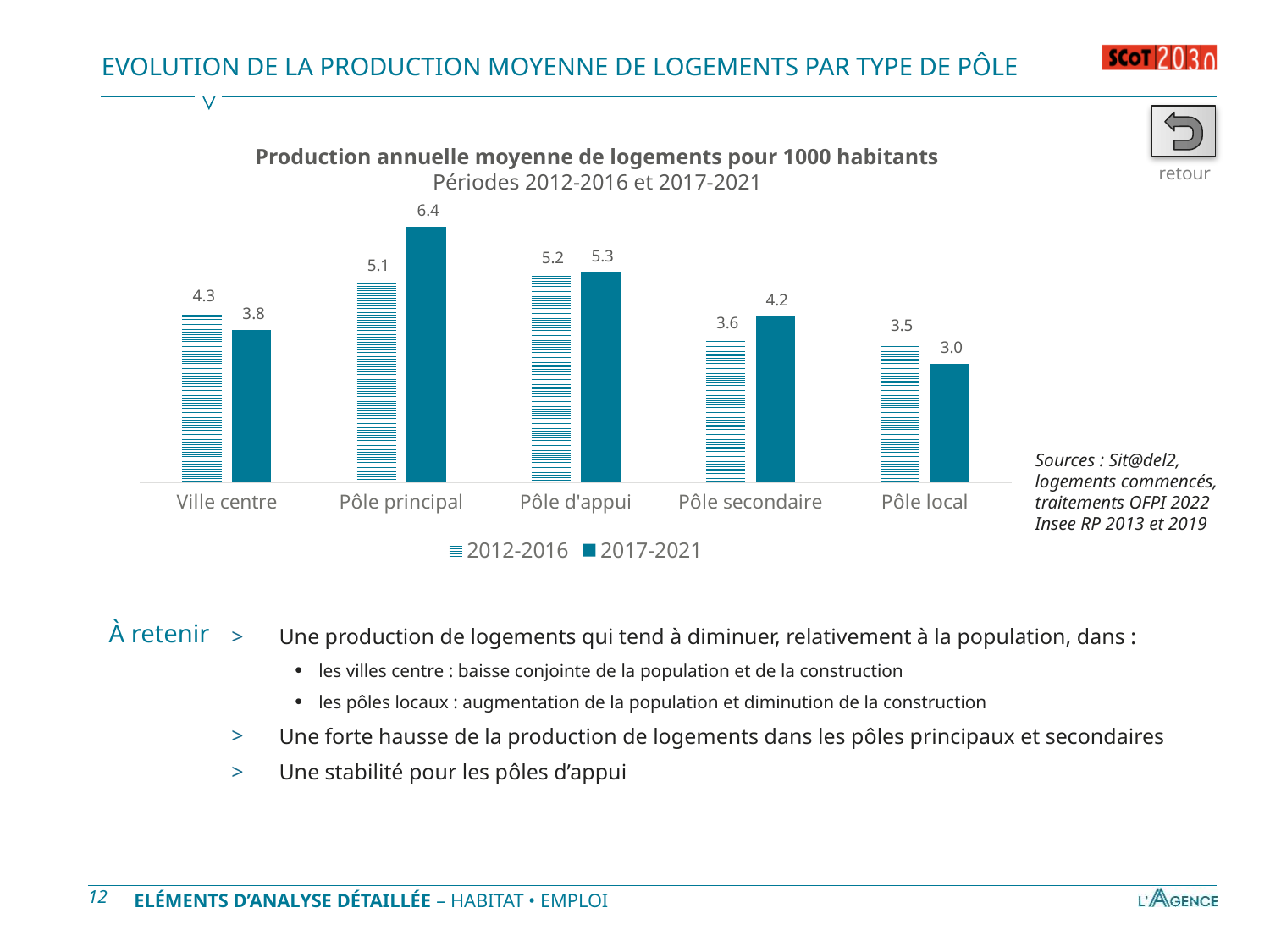
What is the value for Pôle principal in the 2017-2021 series? 6.4 What is the difference between the 2012-2016 and 2017-2021 values for Ville centre? 0.5 What is the value for Ville centre in the 2012-2016 series? 4.3 Which is larger for Pôle secondaire: the 2012-2016 value or the 2017-2021 value? 2017-2021 Which category has the lowest value in the 2012-2016 series? Pôle local What kind of chart is shown on the slide? Bar chart How many categories are shown on the x axis? 5 What is the value for Pôle local in the 2017-2021 series? 3.0 What is the title of the chart? Production annuelle moyenne de logements pour 1000 habitants What is the difference between the 2017-2021 and 2012-2016 values for Pôle principal? 1.3 How many series does the legend list? 2 Which category has the highest value in the 2017-2021 series? Pôle principal